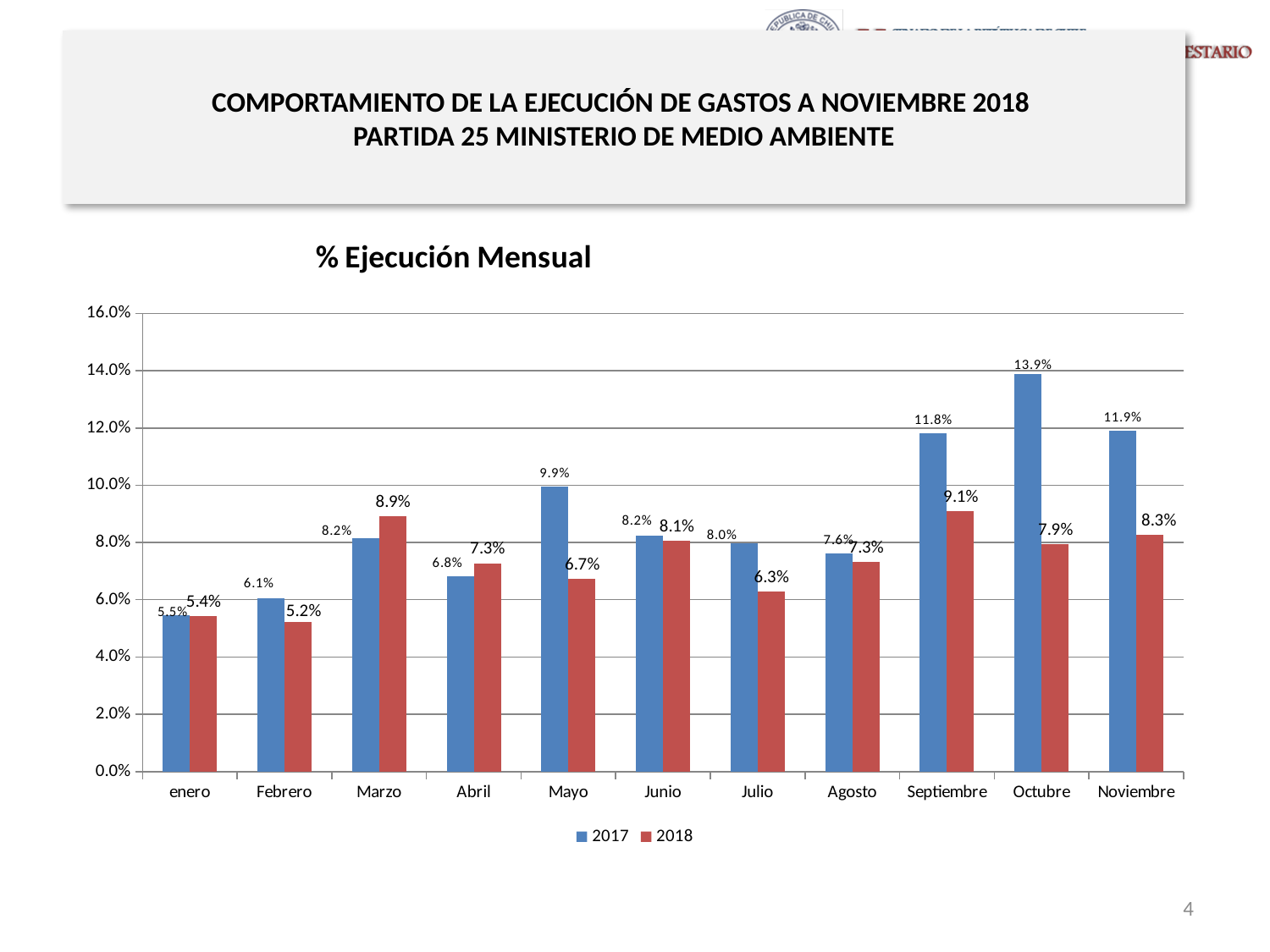
What is the value for 2018 in Marzo? 8.9% What is the title of the chart? % Ejecución Mensual Which month has the lowest value for the 2018 series? Febrero How many series does the legend list? 2 What is the value for 2018 in Noviembre? 8.3% Which month has the highest value for the 2017 series? Octubre How many months are shown on the x axis? 11 Is the value for 2017 in Septiembre greater or less than 10.0%? greater Which is larger in Marzo, the 2017 value or the 2018 value? 2018 What is the difference between the 2017 and 2018 values in Mayo? 3.2% What is the value for 2017 in Octubre? 13.9% What kind of chart is shown? bar chart